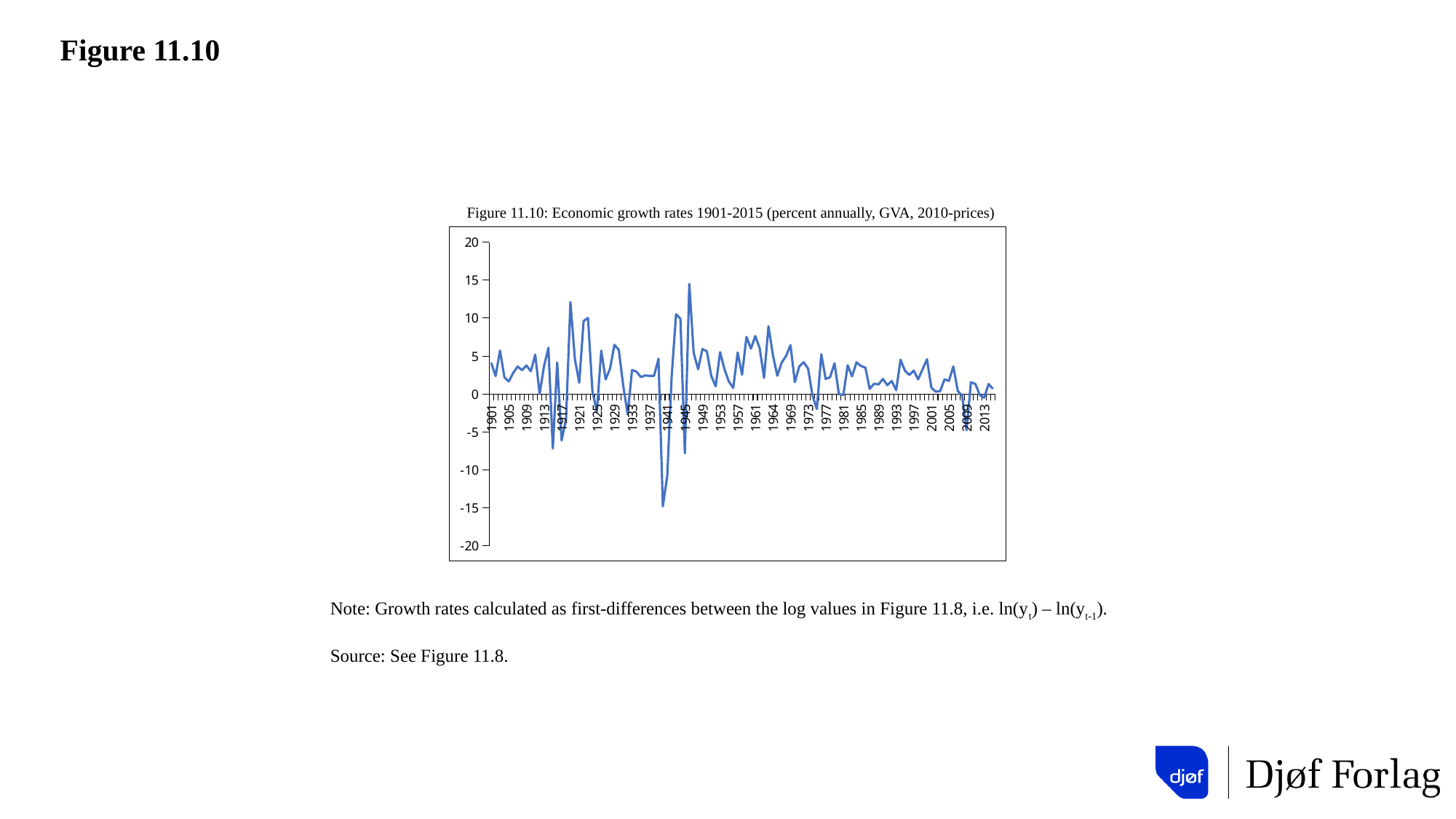
What is the first year labelled on the x axis? 1901 In which decade does the lowest growth rate on the chart occur? 1940s What is the title of the chart? Figure 11.10: Economic growth rates 1901-2015 (percent annually, GVA, 2010-prices) Is the growth rate for 1901 greater or less than 0? greater Is the growth rate for 2009 greater or less than 0? less Is the lowest growth rate plotted on the chart greater or less than -10? less In which decade does the highest growth rate on the chart occur? 1940s What is the highest value shown on the y axis of the chart? 20 Do the growth rates become more or less volatile over the period shown? less volatile What kind of chart is shown on the slide? Line chart How many lines (series) are plotted on the chart? 1